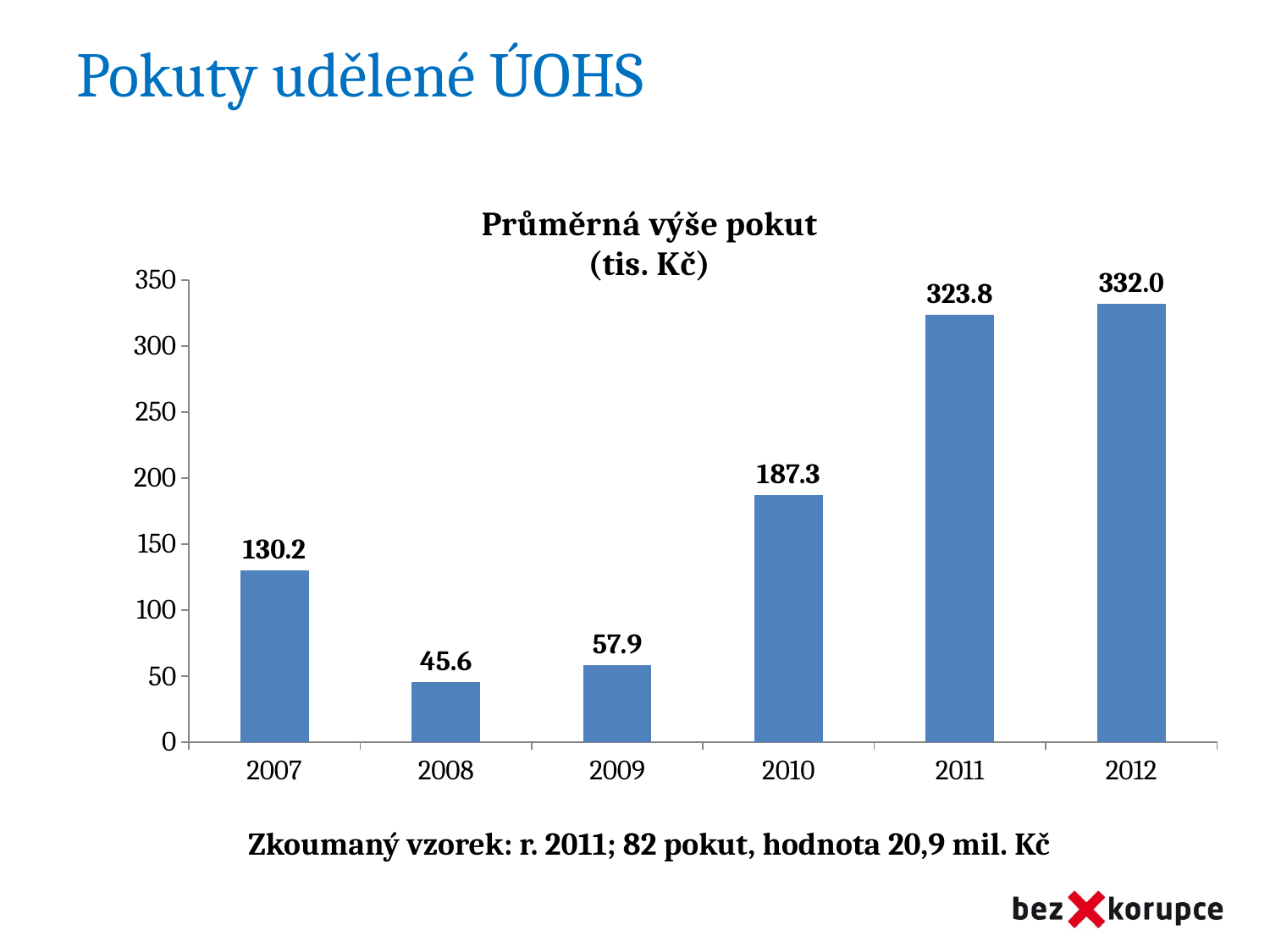
What kind of chart is shown? bar chart What is the value for 2010? 187.3 What is the difference between the values for 2010 and 2009? 129.4 Is the value for 2011 greater or less than 300? greater Which year has the lowest value? 2008 Which is larger, the value for 2007 or the value for 2009? 2007 Which year has the highest value? 2012 How many years are shown on the x axis? 6 What is the value for 2007? 130.2 What is the value for 2008? 45.6 What is the title of the chart? Průměrná výše pokut (tis. Kč) What is the difference between the values for 2012 and 2011? 8.2